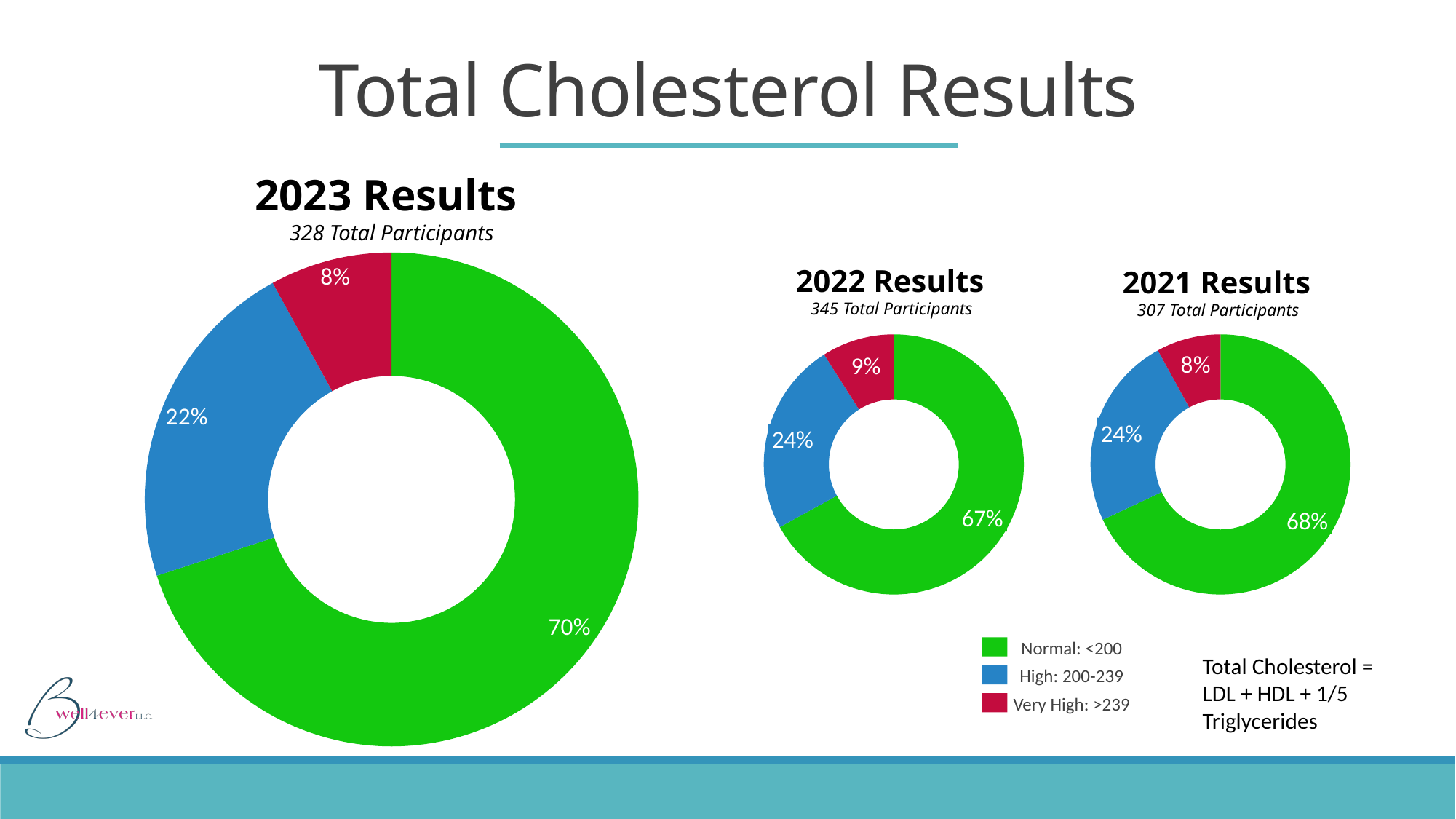
In the 2023 Results chart, what is the difference in percentage points between the Normal and High categories? 48 In the 2021 Results chart, what percentage of participants were in the High (200-239) category? 24% How many categories does each donut chart show? 3 In the 2023 Results chart, what percentage of participants had Normal (<200) total cholesterol? 70% In the 2022 Results chart, what percentage of participants were in the Very High (>239) category? 9% What type of chart is used for the 2023 Results? Donut (pie) chart In the 2022 Results chart, which category has the smallest share? Very High: >239 How many entries does the legend list? 3 Is the Normal share larger in the 2023 Results chart or the 2022 Results chart? 2023 Results How many total participants are reported for the 2022 Results chart? 345 Which colour represents the Very High (>239) category in the charts? Red In the 2023 Results chart, which category has the largest share? Normal: <200